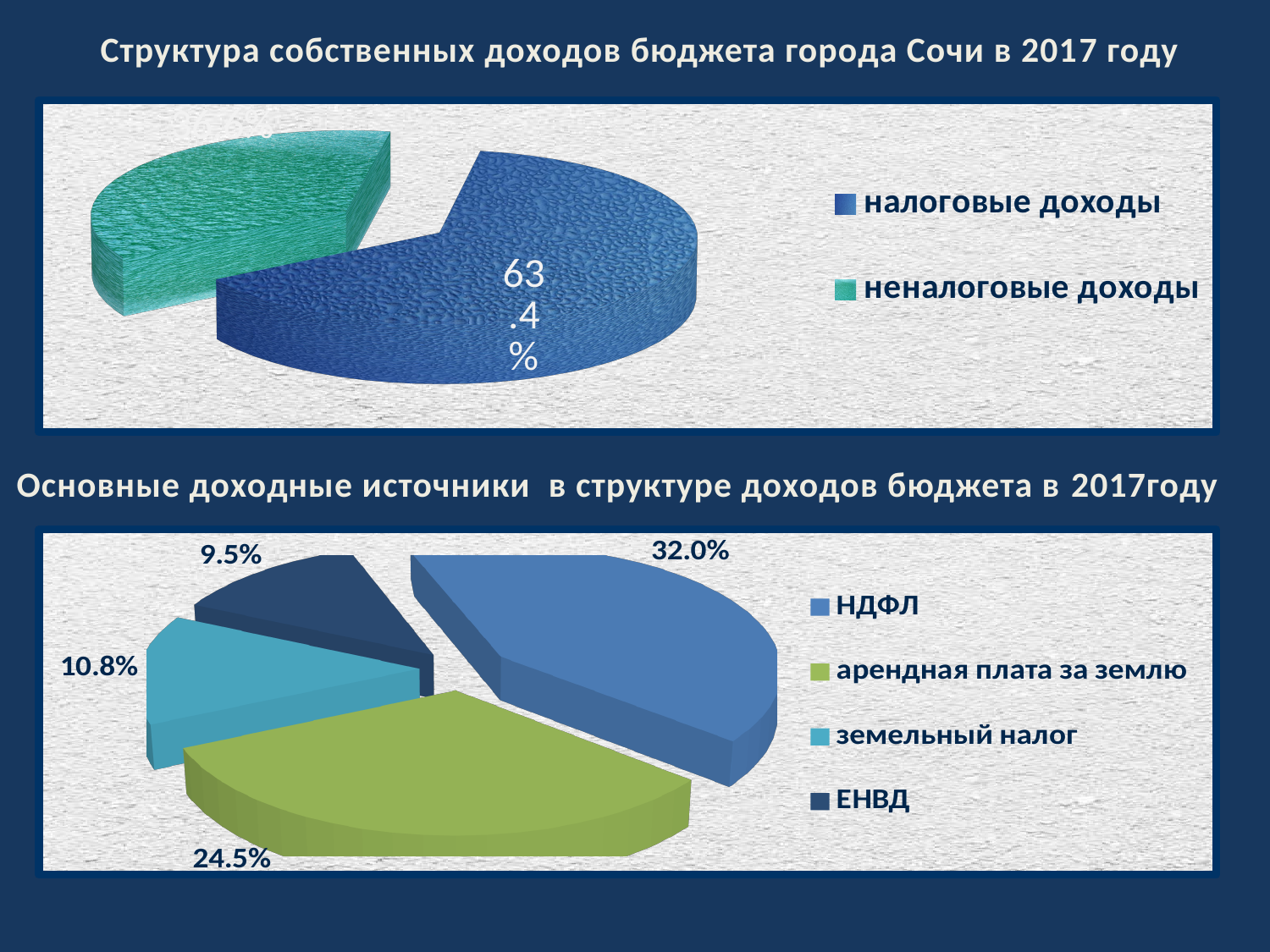
How many categories does the legend of the top chart list? 2 In the bottom chart, what share is shown for арендная плата за землю? 24.5% How many categories are shown in the bottom chart? 4 In the top chart, which category has the larger slice, налоговые доходы or неналоговые доходы? налоговые доходы In the bottom chart (Основные доходные источники в структуре доходов бюджета в 2017году), what share is shown for НДФЛ? 32.0% In the top chart (Структура собственных доходов бюджета города Сочи в 2017 году), what share is shown for налоговые доходы? 63.4% In the bottom chart, what is the difference between the shares of НДФЛ and арендная плата за землю? 7.5% In the bottom chart, what share is shown for ЕНВД? 9.5% In the bottom chart, what share is shown for земельный налог? 10.8% In the bottom chart, which category has the smallest share? ЕНВД In the bottom chart, which category has the largest share? НДФЛ What kind of chart is the top chart on the slide? Pie chart